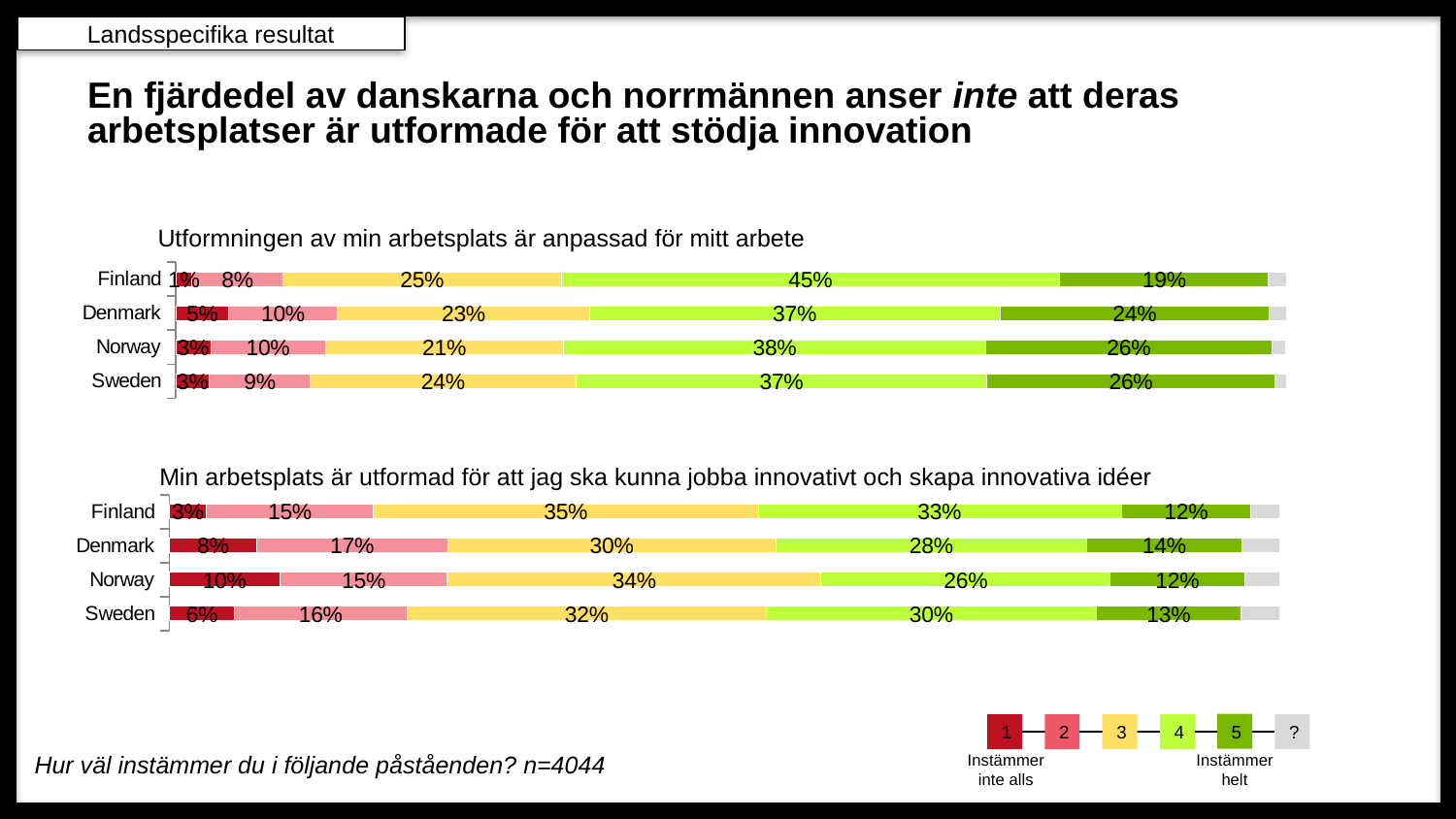
How many countries are shown in the chart titled "Utformningen av min arbetsplats är anpassad för mitt arbete"? 4 In the chart titled "Utformningen av min arbetsplats är anpassad för mitt arbete", which country has the highest share for rating 4? Finland In the chart titled "Min arbetsplats är utformad för att jag ska kunna jobba innovativt och skapa innovativa idéer", which country has the highest share for rating 1? Norway In the chart titled "Utformningen av min arbetsplats är anpassad för mitt arbete", what share of respondents in Denmark gave a rating of 5 (Instämmer helt)? 24% In the chart titled "Utformningen av min arbetsplats är anpassad för mitt arbete", what is the difference between Norway's and Finland's share for rating 5? 7% In the chart titled "Min arbetsplats är utformad för att jag ska kunna jobba innovativt och skapa innovativa idéer", what is the difference between Denmark's and Finland's share for rating 2? 2% In the chart titled "Min arbetsplats är utformad för att jag ska kunna jobba innovativt och skapa innovativa idéer", is the share for rating 4 larger in Finland or in Norway? Finland What kind of chart is used on this slide? Stacked bar chart In the chart titled "Min arbetsplats är utformad för att jag ska kunna jobba innovativt och skapa innovativa idéer", what share of respondents in Norway gave a rating of 1? 10% In the chart titled "Utformningen av min arbetsplats är anpassad för mitt arbete", which country has the lowest share for rating 1 (Instämmer inte alls)? Finland In the chart titled "Utformningen av min arbetsplats är anpassad för mitt arbete", what share of respondents in Finland gave a rating of 4? 45% In the chart titled "Min arbetsplats är utformad för att jag ska kunna jobba innovativt och skapa innovativa idéer", what share of respondents in Sweden gave a rating of 3? 32%